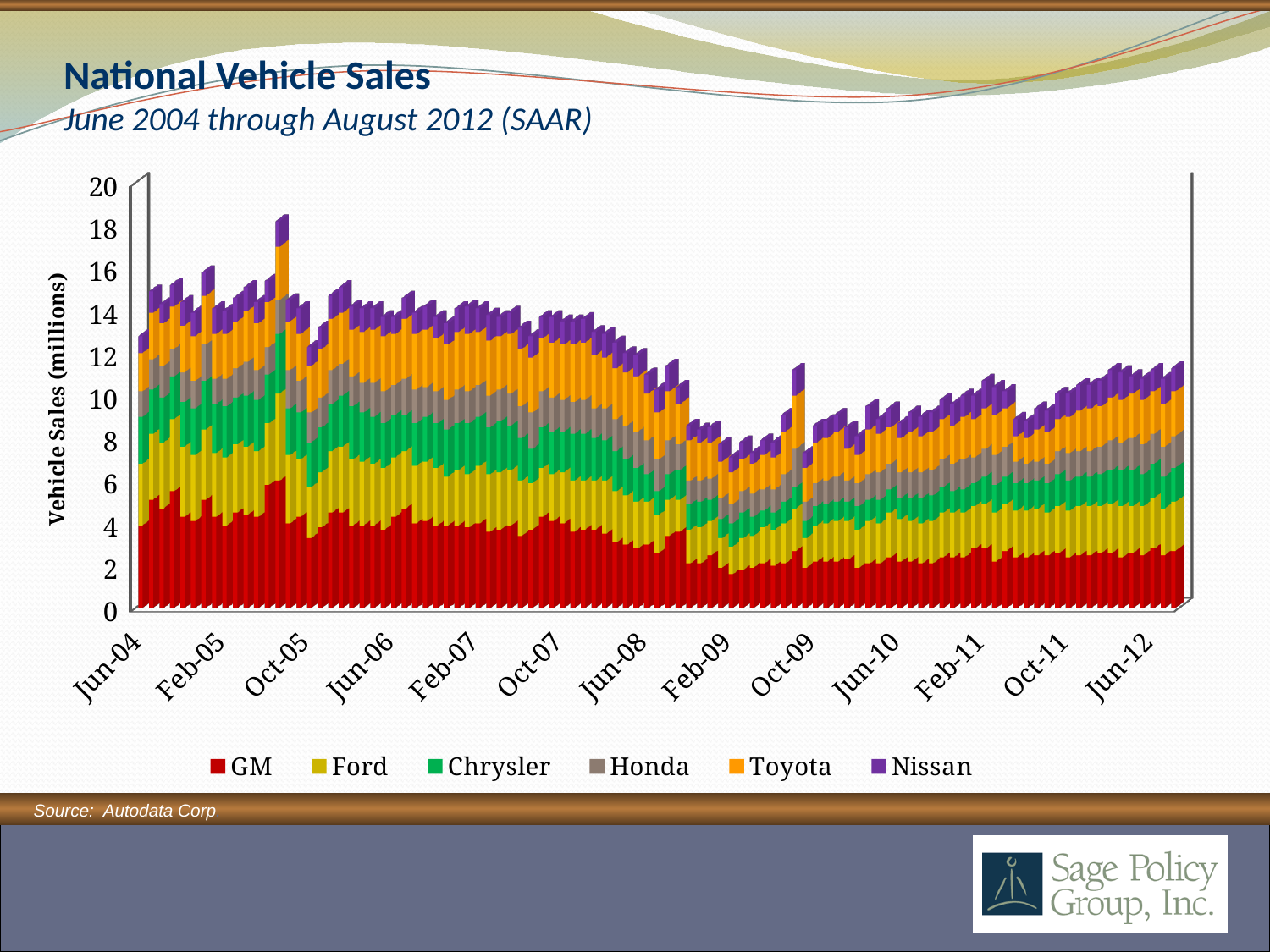
Do total vehicle sales generally rise or fall between Feb-09 and Jun-12? rise How many series does the legend list? 6 What is the label on the vertical axis? Vehicle Sales (millions) Is the total vehicle sales value for Jun-04 greater or less than 10? greater Which manufacturers are listed in the legend? GM, Ford, Chrysler, Honda, Toyota, Nissan Is the tallest stacked bar on the chart greater or less than 16? greater What kind of chart is shown on the slide? Stacked bar chart Do total vehicle sales generally rise or fall between Jun-04 and Feb-09? fall How many date labels are shown on the x axis? 13 Which has the larger total vehicle sales, Jun-04 or Feb-09? Jun-04 Is the total vehicle sales value for Jun-12 greater or less than 10? greater